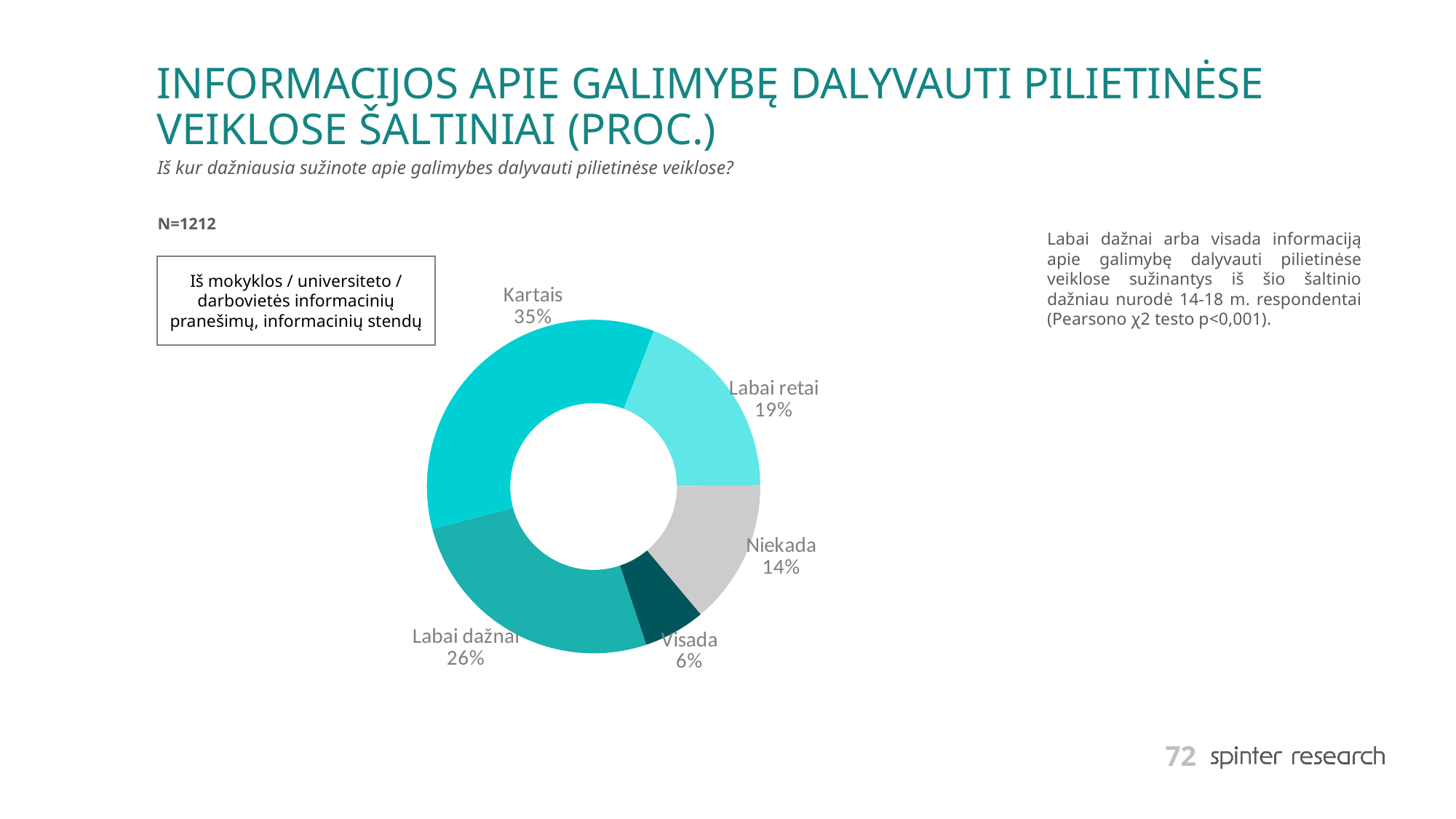
What sample size (N) is stated on the slide? N=1212 What kind of chart is shown on the slide? Doughnut (pie) chart Which is larger, the share for "Labai dažnai" or the share for "Niekada"? Labai dažnai What percentage of respondents answered "Kartais"? 35% What percentage of respondents answered "Niekada"? 14% Which category has the largest share of the chart? Kartais What percentage of respondents answered "Visada"? 6% What percentage of respondents answered "Labai dažnai"? 26% What is the combined share of "Labai dažnai" and "Visada"? 32% What is the difference in percentage points between "Kartais" and "Labai retai"? 16 Which category has the smallest share of the chart? Visada How many categories are shown in the chart? 5